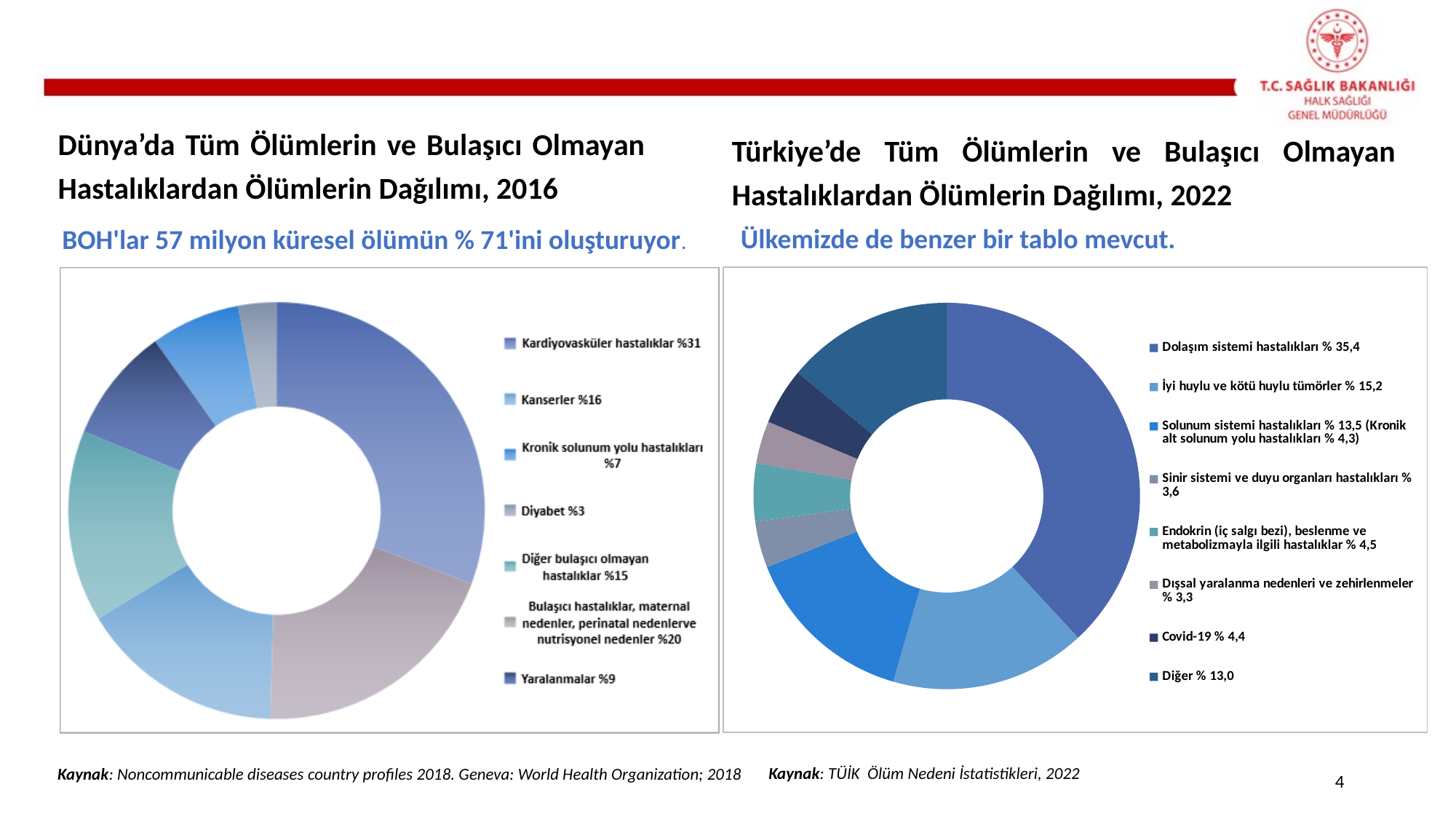
In the left chart (Dünya, 2016), how many categories does the legend list? 7 In the right chart (Türkiye, 2022), how many categories does the legend list? 8 In the left chart (Dünya, 2016), which category has the largest share? Kardiyovasküler hastalıklar In the left chart (Dünya, 2016), what percentage is shown for Diyabet? %3 In the left chart (Dünya, 2016), what is the difference in percentage points between Kanserler and Yaralanmalar? 7 What type of chart is used on the left side of the slide (Dünya, 2016)? Doughnut (pie) chart In the left chart (Dünya, 2016), which category has the smallest share? Diyabet In the right chart (Türkiye, 2022), which is larger: İyi huylu ve kötü huylu tümörler or Solunum sistemi hastalıkları? İyi huylu ve kötü huylu tümörler In the left chart (Dünya, 2016), what percentage is shown for Kardiyovasküler hastalıklar? %31 In the right chart (Türkiye, 2022), what percentage is shown for Covid-19? % 4,4 In the right chart (Türkiye, 2022), what percentage is shown for Dolaşım sistemi hastalıkları? % 35,4 In the right chart (Türkiye, 2022), which category has the smallest share? Dışsal yaralanma nedenleri ve zehirlenmeler